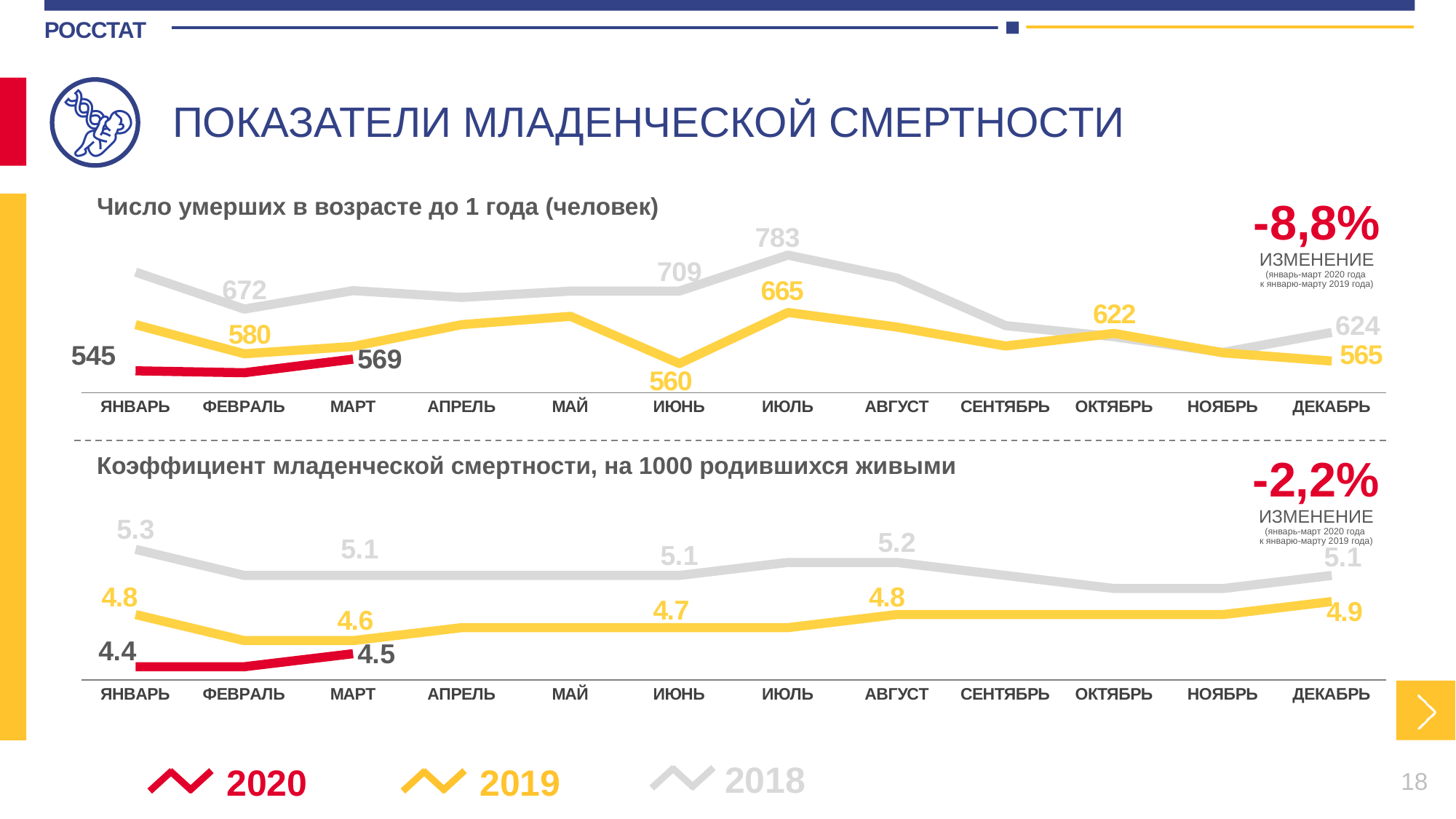
In the bottom chart (Коэффициент младенческой смертности), what is the difference between the 2018 and 2019 values in January (ЯНВАРЬ)? 0.5 What kind of chart is the bottom chart (Коэффициент младенческой смертности)? Line chart How many series does the legend at the bottom of the slide list? 3 In the top chart (Число умерших в возрасте до 1 года), which is larger in February (ФЕВРАЛЬ): the 2018 value or the 2019 value? 2018 In the top chart (Число умерших в возрасте до 1 года), what is the difference between the 2018 and 2019 values in December (ДЕКАБРЬ)? 59 In the bottom chart (Коэффициент младенческой смертности), what is the value for 2020 in January (ЯНВАРЬ)? 4.4 In the top chart (Число умерших в возрасте до 1 года), what is the value for 2020 in March (МАРТ)? 569 In the top chart (Число умерших в возрасте до 1 года), what is the value for 2018 in July (ИЮЛЬ)? 783 In the top chart (Число умерших в возрасте до 1 года), how much did the 2020 value change from January to March? 24 In the top chart (Число умерших в возрасте до 1 года), what is the value for 2019 in June (ИЮНЬ)? 560 How many months are shown on the x axis of the top chart? 12 In the bottom chart (Коэффициент младенческой смертности), what is the value for 2019 in December (ДЕКАБРЬ)? 4.9